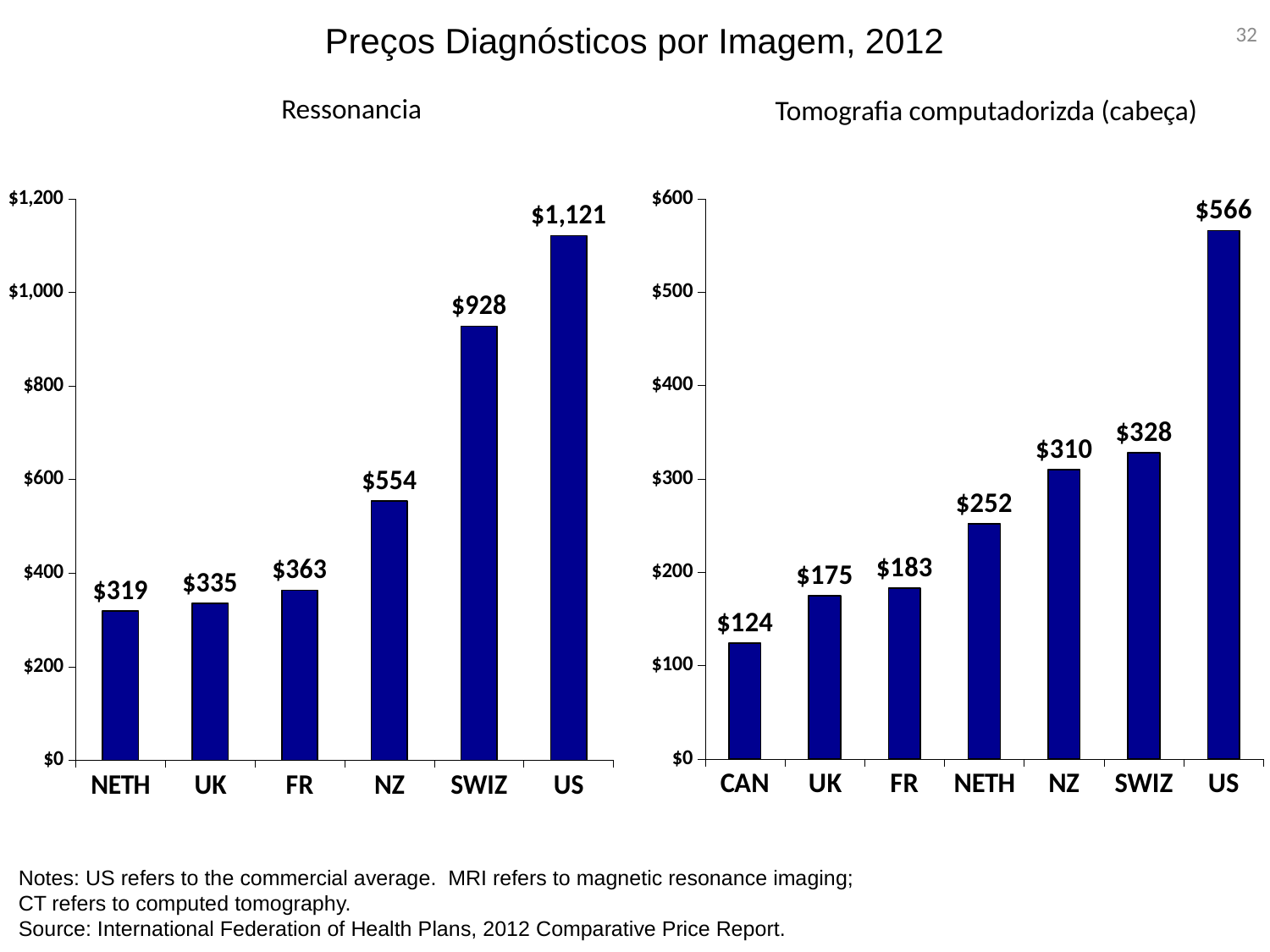
In the Ressonancia chart, which is larger, the value for NZ or the value for FR? NZ How many countries are shown in the Ressonancia chart? 6 In the Tomografia computadorizda (cabeça) chart, which country has the lowest value? CAN In the Tomografia computadorizda (cabeça) chart, what is the difference between the US value and the SWIZ value? $238 In the Tomografia computadorizda (cabeça) chart, do the values rise or fall from left to right? Rise In the Tomografia computadorizda (cabeça) chart, is the value for NZ greater or less than $300? greater How many countries are shown in the Tomografia computadorizda (cabeça) chart? 7 In the Tomografia computadorizda (cabeça) chart, what is the value for NETH? $252 In the Ressonancia chart, which country has the highest value? US What kind of chart is the Ressonancia chart? Bar chart In the Ressonancia chart, what is the value for SWIZ? $928 In the Ressonancia chart, what is the difference between the US value and the SWIZ value? $193